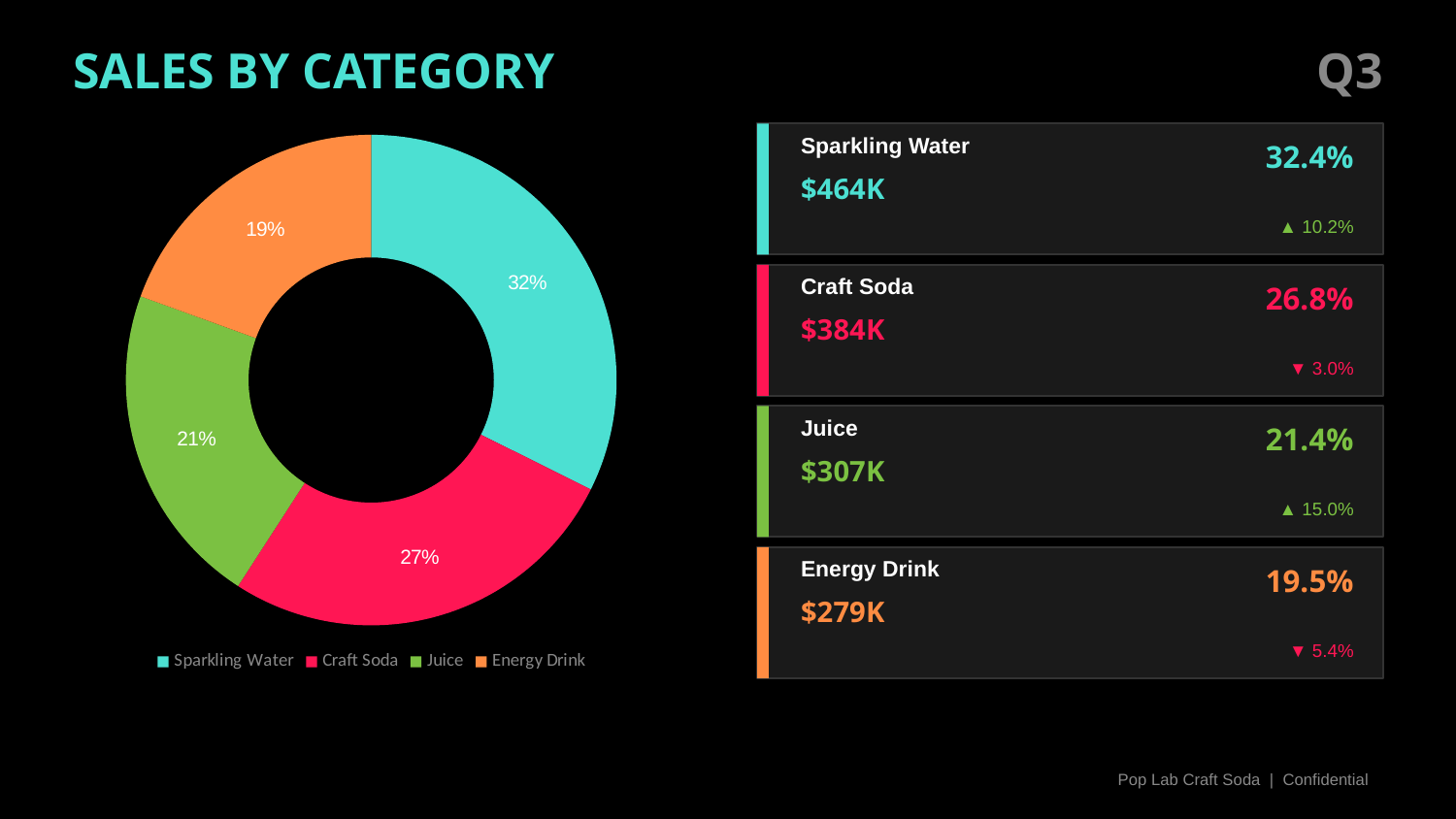
What colour represents Juice in the chart legend? Green What is the difference in percentage points between Sparkling Water and Energy Drink in the chart? 13 Which category has the largest share in the chart? Sparkling Water What percentage does the chart show for Energy Drink? 19% What percentage does the chart show for Sparkling Water? 32% Which has a larger share in the chart, Craft Soda or Juice? Craft Soda How many categories does the chart show? 4 What kind of chart is shown on the slide? Donut chart What is the title of the slide containing the chart? SALES BY CATEGORY Which category has the smallest share in the chart? Energy Drink What percentage does the chart show for Juice? 21% What percentage does the chart show for Craft Soda? 27%